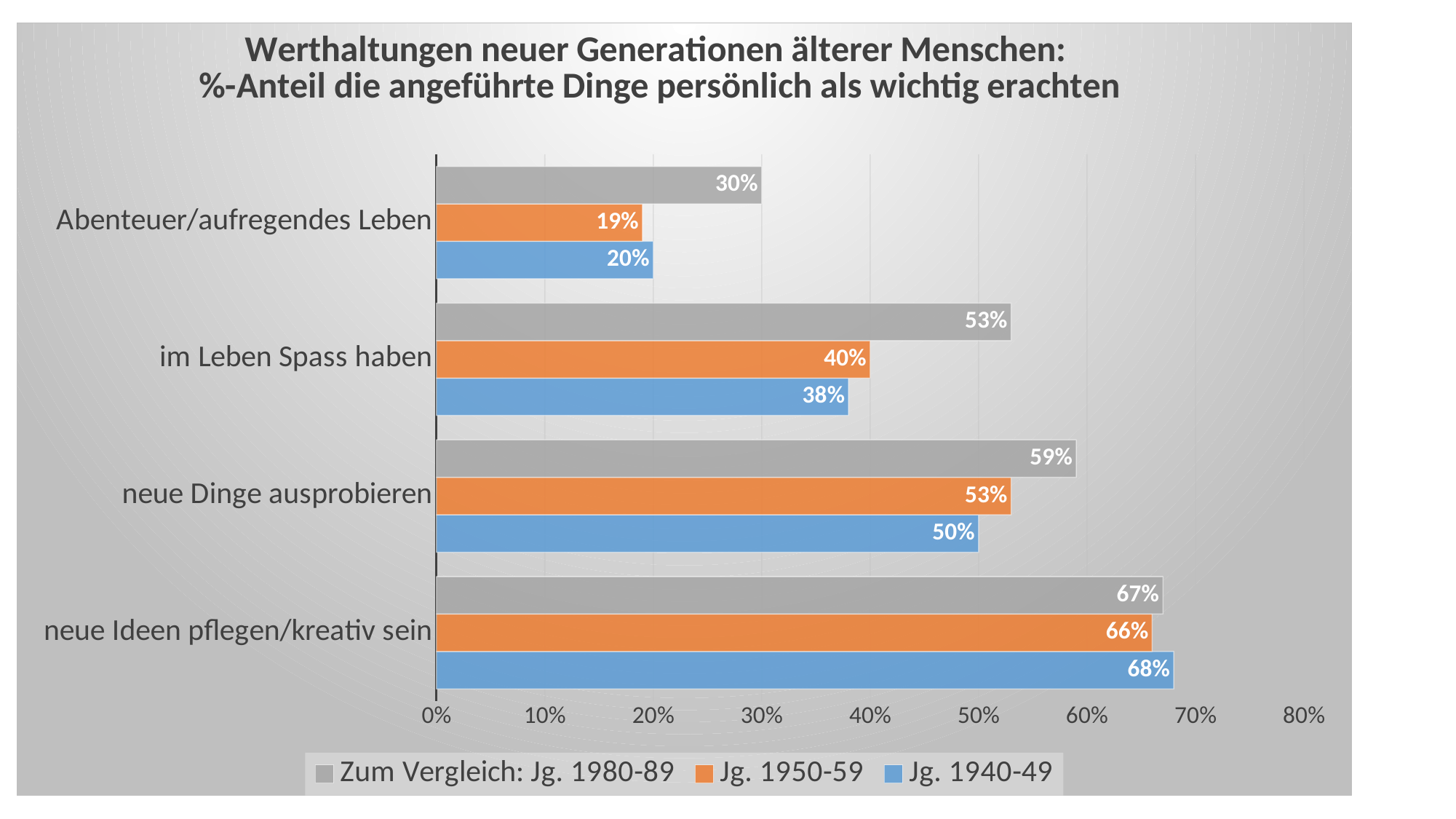
What is the value for Jg. 1950-59 for "im Leben Spass haben"? 40% Is the Jg. 1950-59 value for "Abenteuer/aufregendes Leben" greater or less than 20%? less Which category has the highest value for Jg. 1950-59? neue Ideen pflegen/kreativ sein For "neue Dinge ausprobieren", which series has the larger value: Jg. 1950-59 or Jg. 1940-49? Jg. 1950-59 Which category has the lowest value for Jg. 1940-49? Abenteuer/aufregendes Leben How many series does the legend list? 3 What is the value for Jg. 1940-49 for "neue Ideen pflegen/kreativ sein"? 68% Which colour represents the Jg. 1950-59 series? orange What is the value for Zum Vergleich: Jg. 1980-89 for "Abenteuer/aufregendes Leben"? 30% What is the difference between the Zum Vergleich: Jg. 1980-89 value and the Jg. 1940-49 value for "im Leben Spass haben"? 15% How many categories are shown on the chart? 4 What kind of chart is shown on the slide? bar chart